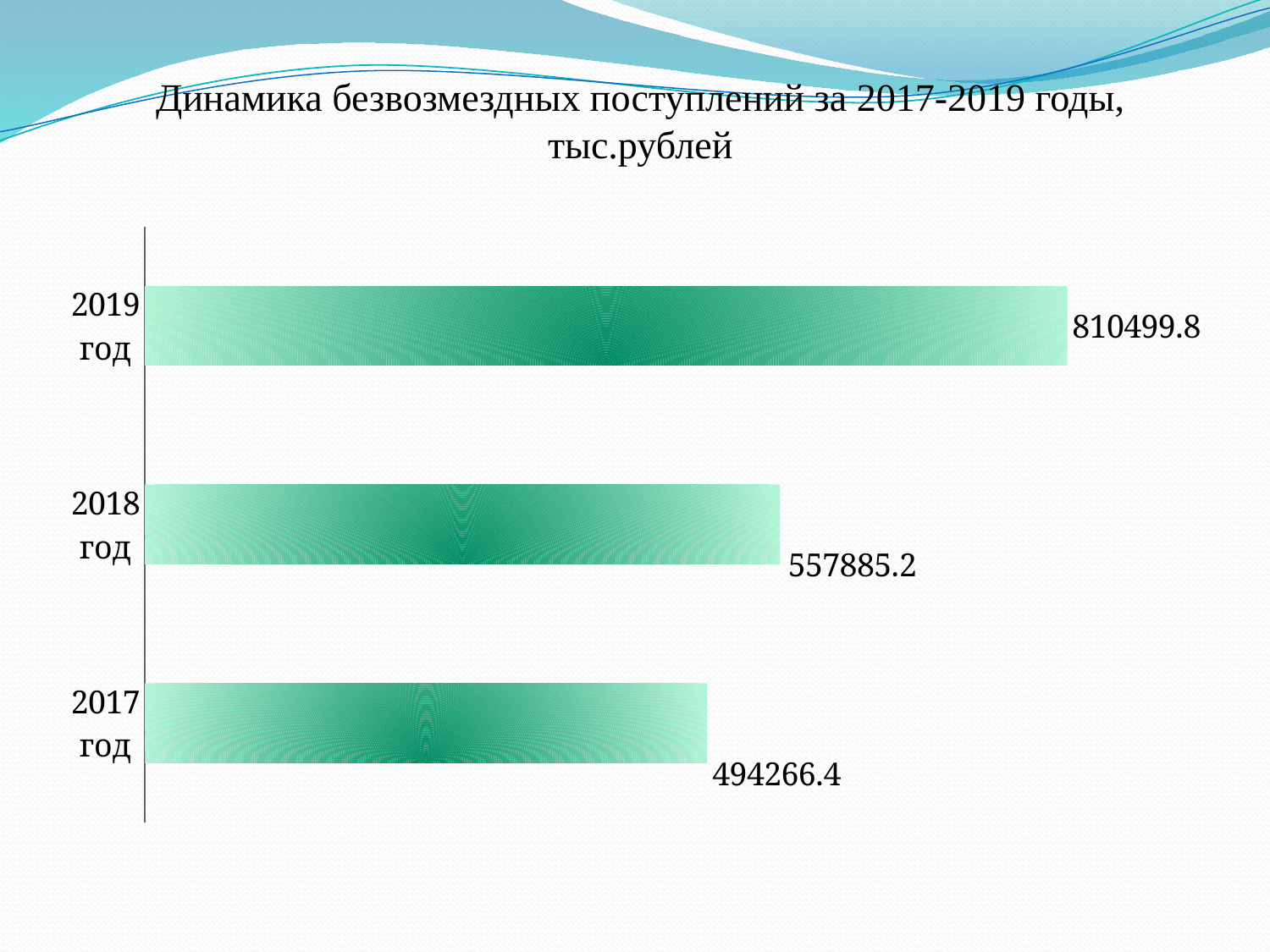
What is the value for 2017 год? 494266.4 What is the difference between the values for 2019 год and 2018 год? 252614.6 Which is larger, the value for 2018 год or the value for 2017 год? 2018 год What kind of chart is shown on the slide? bar chart Do the values rise or fall from 2017 to 2019? rise Which year has the highest value? 2019 год What is the value for 2019 год? 810499.8 Which year has the lowest value? 2017 год How many years are shown in the chart? 3 What is the title of the chart? Динамика безвозмездных поступлений за 2017-2019 годы, тыс.рублей What is the value for 2018 год? 557885.2 What is the difference between the values for 2018 год and 2017 год? 63618.8